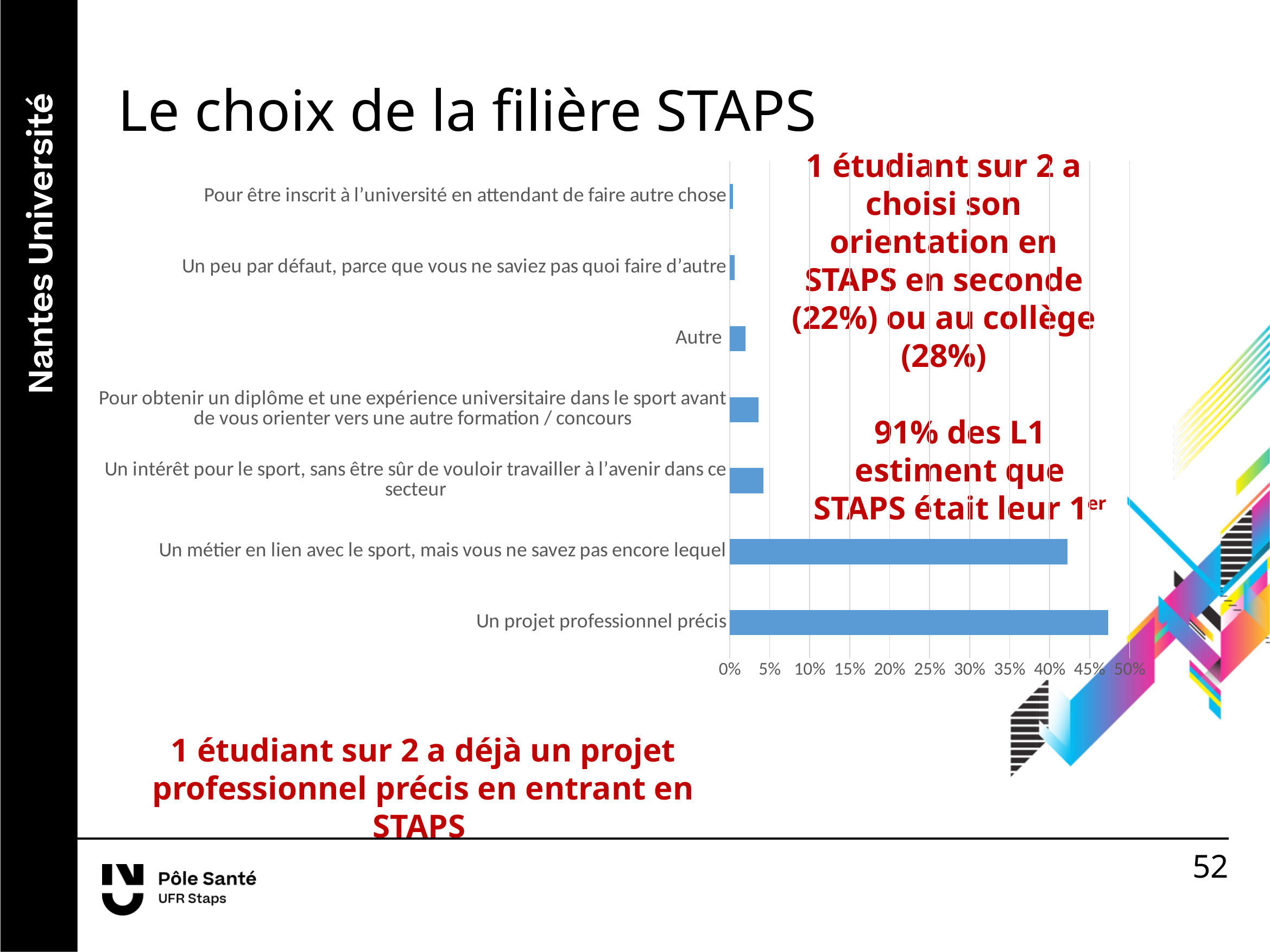
Is the value for "Autre" greater or less than 5%? less What kind of chart is shown on the slide? bar chart What colour are the bars in the chart? blue How many categories (reasons) are plotted in the bar chart? 7 Which is larger: the value for "Autre" or the value for "Un intérêt pour le sport, sans être sûr de vouloir travailler à l'avenir dans ce secteur"? Un intérêt pour le sport, sans être sûr de vouloir travailler à l'avenir dans ce secteur Is the value for "Un métier en lien avec le sport, mais vous ne savez pas encore lequel" greater or less than 40%? greater Is the value for "Un métier en lien avec le sport, mais vous ne savez pas encore lequel" greater or less than 45%? less What is the highest tick value shown on the horizontal axis of the chart? 50% Which is larger: the value for "Un projet professionnel précis" or the value for "Un métier en lien avec le sport, mais vous ne savez pas encore lequel"? Un projet professionnel précis Which category has the highest value in the bar chart? Un projet professionnel précis